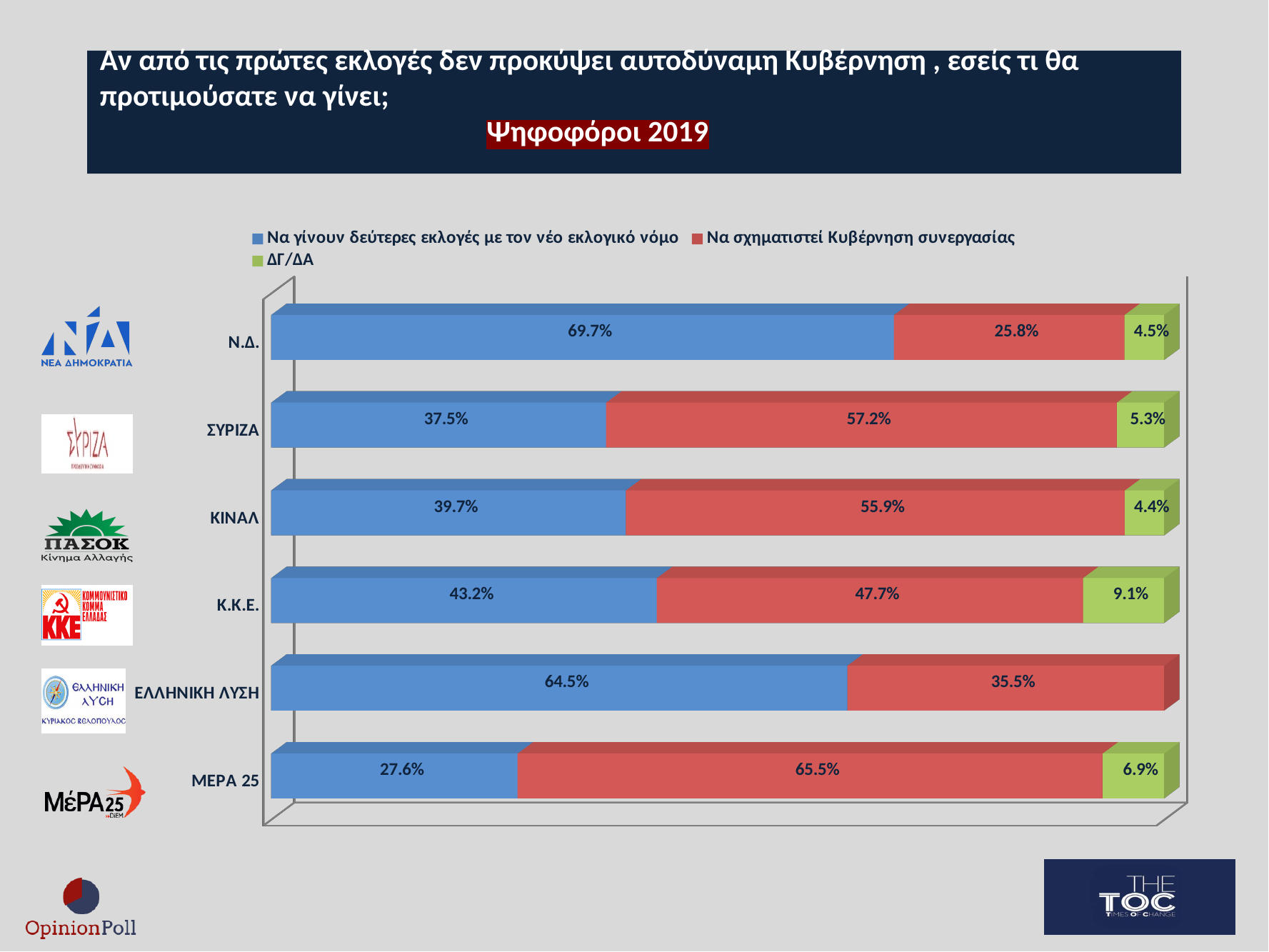
What percentage of Ν.Δ. voters prefer second elections with the new electoral law (Να γίνουν δεύτερες εκλογές με τον νέο εκλογικό νόμο)? 69.7% How many series does the legend list? 3 Which colour represents the ΔΓ/ΔΑ series in the chart? Green How many parties (categories) are shown in the chart? 6 What is the difference between the Ν.Δ. and ΕΛΛΗΝΙΚΗ ΛΥΣΗ values for second elections with the new electoral law? 5.2% Which is larger: the ΚΙΝΑΛ value for second elections with the new electoral law or the ΣΥΡΙΖΑ value for the same option? ΚΙΝΑΛ What is the total of the ΕΛΛΗΝΙΚΗ ΛΥΣΗ bar (sum of its labelled segments)? 100% What percentage of ΣΥΡΙΖΑ voters prefer a coalition government (Να σχηματιστεί Κυβέρνηση συνεργασίας)? 57.2% What is the ΔΓ/ΔΑ value for Κ.Κ.Ε. voters? 9.1% Which party's voters have the lowest share preferring second elections with the new electoral law? ΜΕΡΑ 25 Which party's voters have the highest share preferring a coalition government (Να σχηματιστεί Κυβέρνηση συνεργασίας)? ΜΕΡΑ 25 What kind of chart is shown on the slide? Stacked bar chart